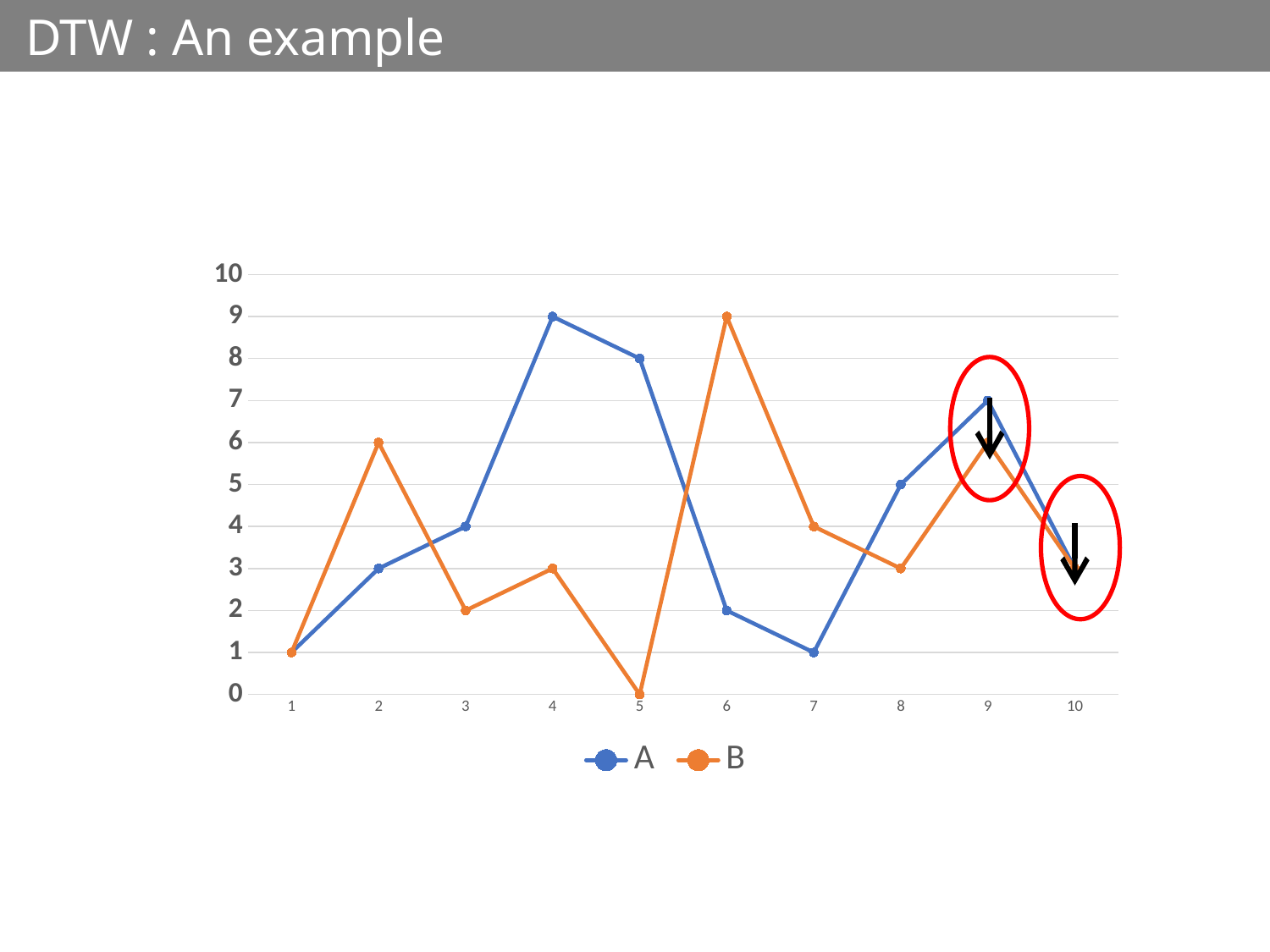
What is the value of series A at x = 4? 9 What is the value of series B at x = 6? 9 How many points are plotted along the x axis for each series? 10 How many series does the legend list? 2 What kind of chart is shown on the slide? line chart At which x value does series B reach its lowest point? 5 At x = 2, which series has the larger value, A or B? B Does series A rise or fall from x = 5 to x = 7? fall At which x value does series A reach its highest point? 4 What is the value of series B at x = 5? 0 Which series is drawn in orange? B What is the difference between series A and series B at x = 9? 1